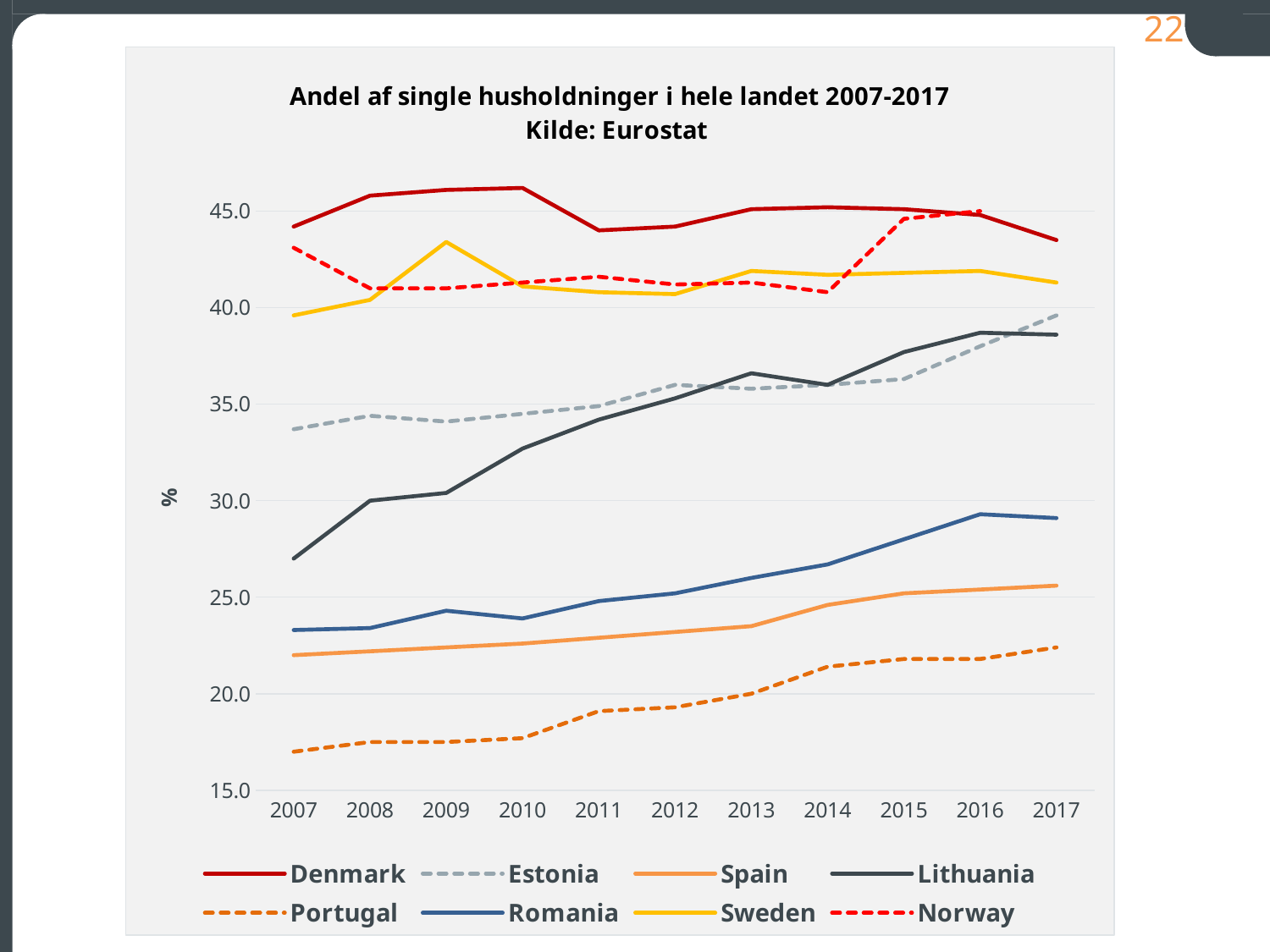
What is the label on the y axis of the chart? % In 2017, which has the larger value, Romania or Spain? Romania Is the value for Portugal in 2007 greater or less than 20.0? less How many years are shown along the x axis? 11 Is the value for Lithuania in 2017 greater or less than 35.0? greater Which country has the lowest share of single households in 2017? Portugal Does the line for Lithuania rise or fall from 2007 to 2017? rise How many countries does the legend list? 8 Is the value for Denmark in 2010 greater or less than 45.0? greater What kind of chart is shown on the slide? line chart Which country has the highest share of single households in 2010? Denmark Does the line for Portugal rise or fall from 2007 to 2017? rise